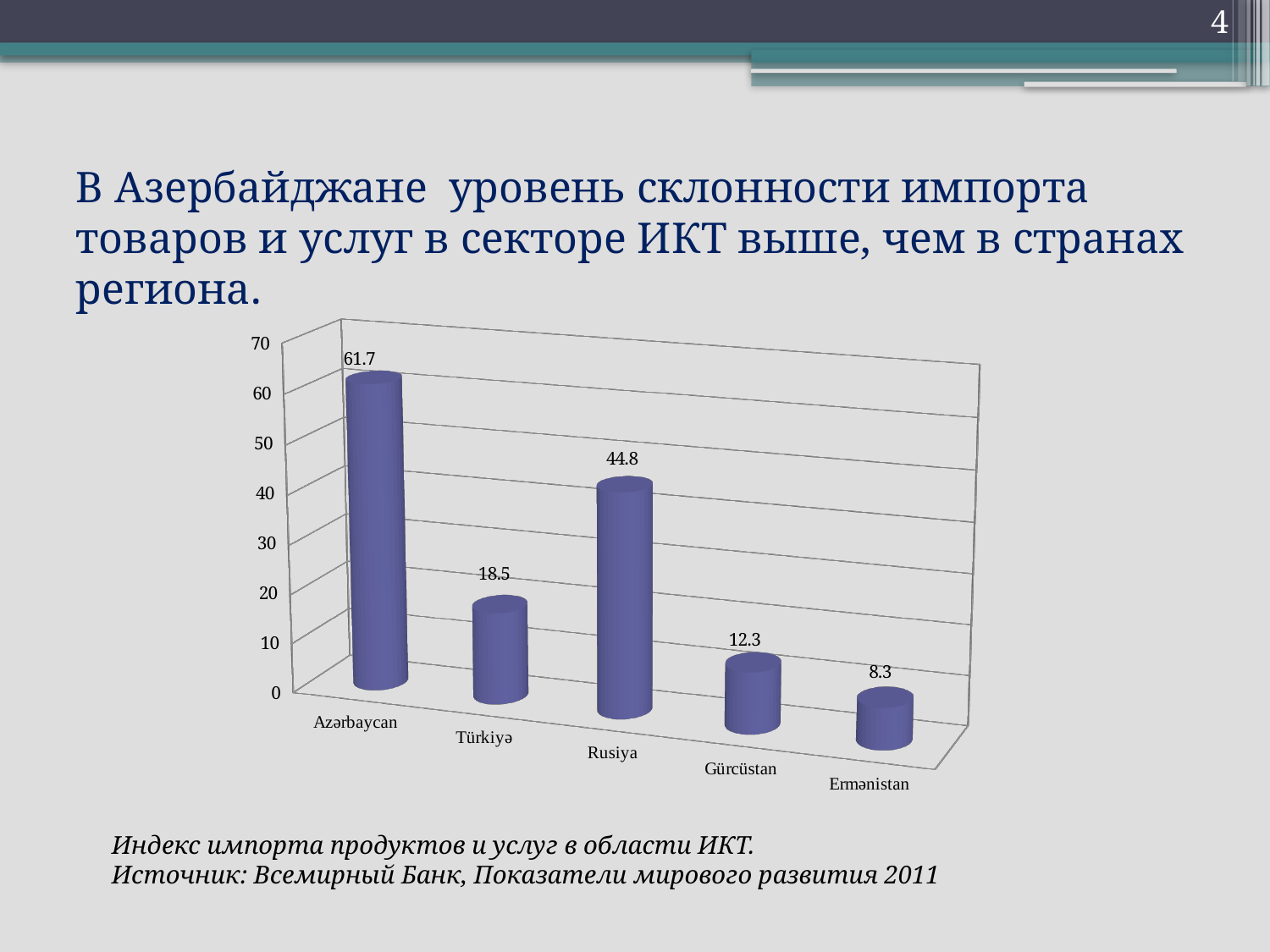
Which country has the highest value? Azərbaycan What is the value for Ermənistan? 8.3 What kind of chart is shown on the slide? Bar chart What is the value for Rusiya? 44.8 Which is larger, the value for Türkiyə or the value for Rusiya? Rusiya How many countries are shown in the chart? 5 Is the value for Türkiyə greater or less than 20? less What is the value for Azərbaycan? 61.7 What is the value for Gürcüstan? 12.3 What is the difference between the values for Azərbaycan and Rusiya? 16.9 What is the difference between the values for Türkiyə and Gürcüstan? 6.2 Which country has the lowest value? Ermənistan